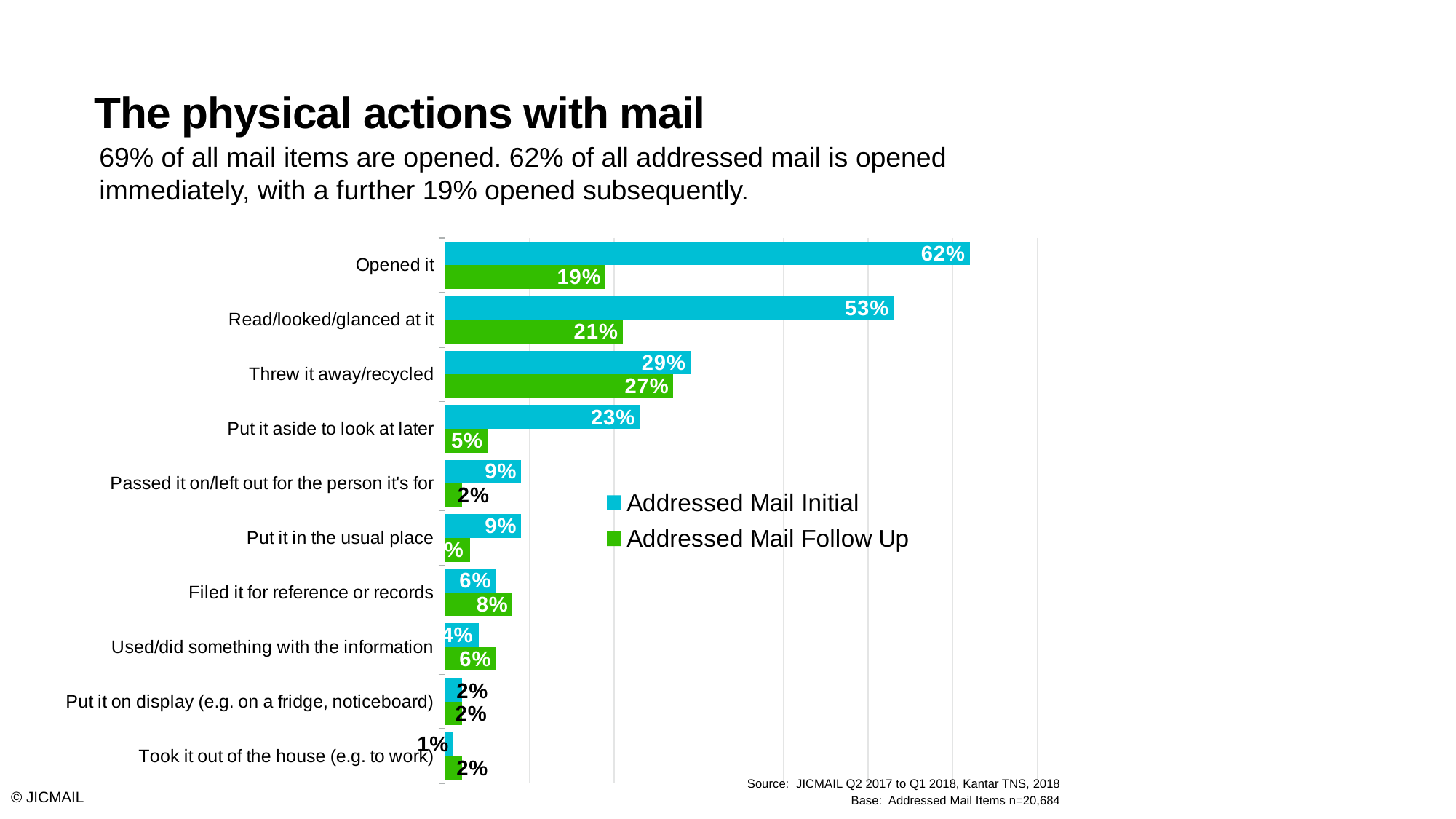
How many series does the legend list? 2 Which colour represents the Addressed Mail Follow Up series? green For "Filed it for reference or records", which is larger: Addressed Mail Initial or Addressed Mail Follow Up? Addressed Mail Follow Up Which category has the lowest Addressed Mail Initial value? Took it out of the house (e.g. to work) What is the difference between the Addressed Mail Initial values for "Read/looked/glanced at it" and "Threw it away/recycled"? 24% What is the Addressed Mail Follow Up value for "Threw it away/recycled"? 27% Which category has the highest Addressed Mail Initial value? Opened it What kind of chart is shown on the slide? bar chart What is the Addressed Mail Initial value for "Opened it"? 62% What is the Addressed Mail Follow Up value for "Read/looked/glanced at it"? 21% What is the difference between the Addressed Mail Initial and Addressed Mail Follow Up values for "Opened it"? 43% How many categories are shown on the chart? 10